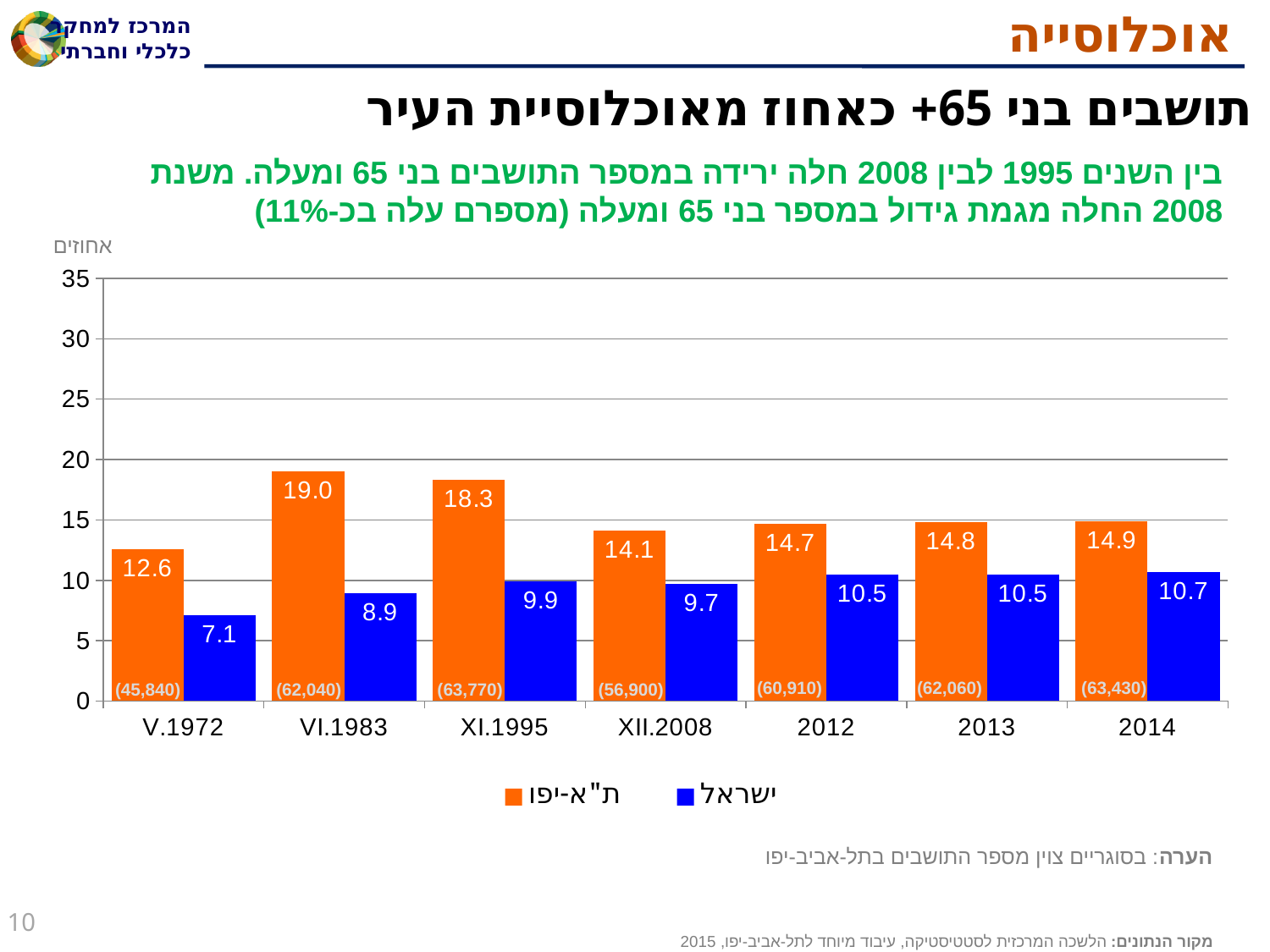
How many series does the legend list? 2 What is the value for ת"א-יפו in XII.2008? 14.1 In which year is the ת"א-יפו value highest? VI.1983 Which is larger in 2012: the ת"א-יפו value or the ישראל value? ת"א-יפו What number is printed in parentheses at the base of the ת"א-יפו bar for XI.1995? (63,770) How many years (categories) are shown on the x axis? 7 In which year is the ישראל value lowest? V.1972 What is the value for ת"א-יפו in VI.1983? 19.0 What is the value for ישראל in 2014? 10.7 Which colour represents the ישראל series? blue What is the difference between the ת"א-יפו and ישראל values in XI.1995? 8.4 What kind of chart is shown on the slide? bar chart